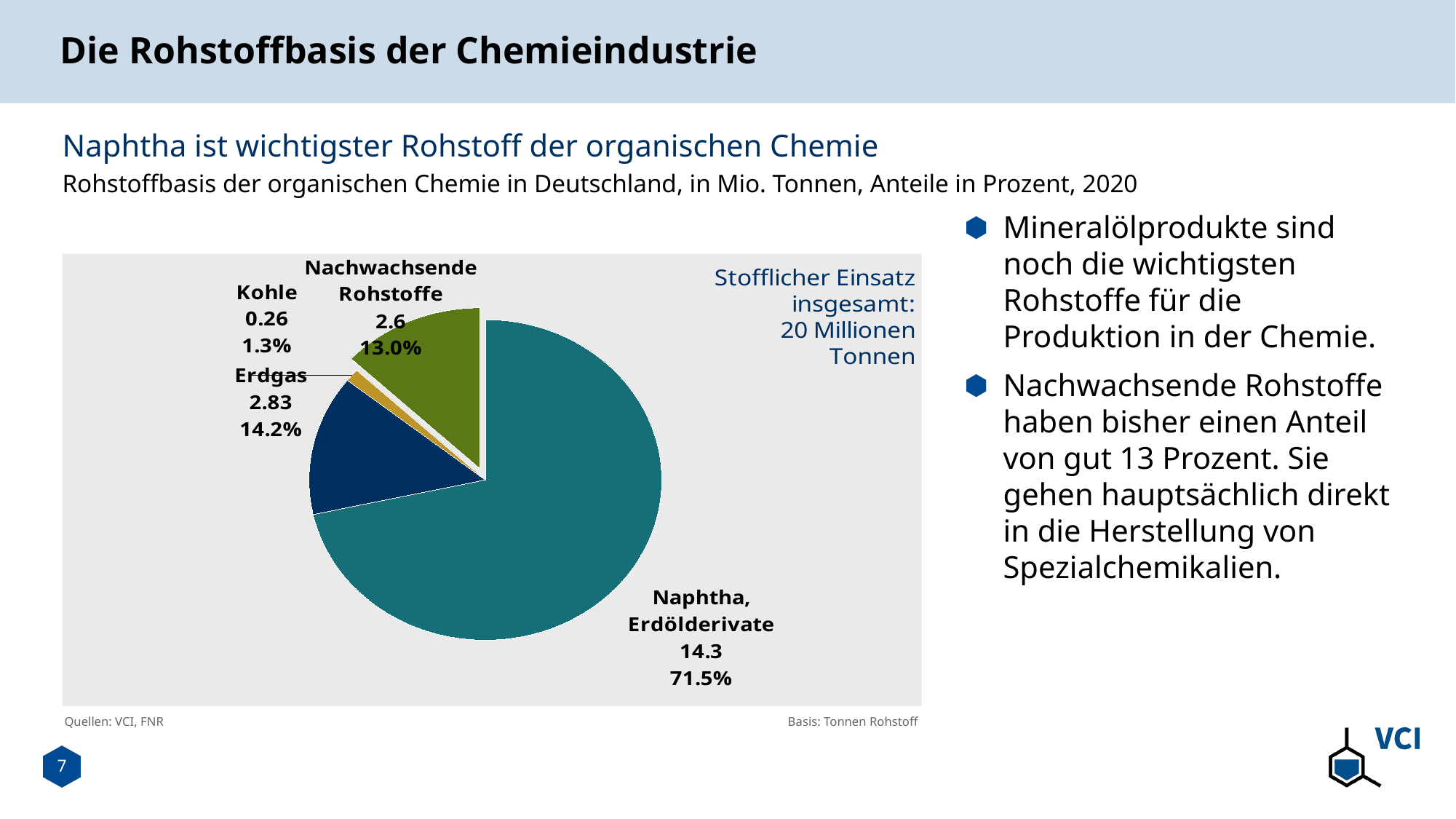
What is the value in Mio. Tonnen for Naphtha, Erdölderivate? 14.3 What kind of chart is shown on the slide? pie chart What share of the pie does Nachwachsende Rohstoffe have? 13.0% What is the difference in percentage points between the share of Naphtha, Erdölderivate and the share of Erdgas? 57.3 According to the text in the chart, what is the total stofflicher Einsatz? 20 Millionen Tonnen Which category has the smallest slice of the pie? Kohle What share of the pie does Naphtha, Erdölderivate have? 71.5% What is the value in Mio. Tonnen for Erdgas? 2.83 Which category has the largest slice of the pie? Naphtha, Erdölderivate What is the value in Mio. Tonnen for Kohle? 0.26 How many slices does the pie chart have? 4 Which is larger, the share for Erdgas or the share for Nachwachsende Rohstoffe? Erdgas